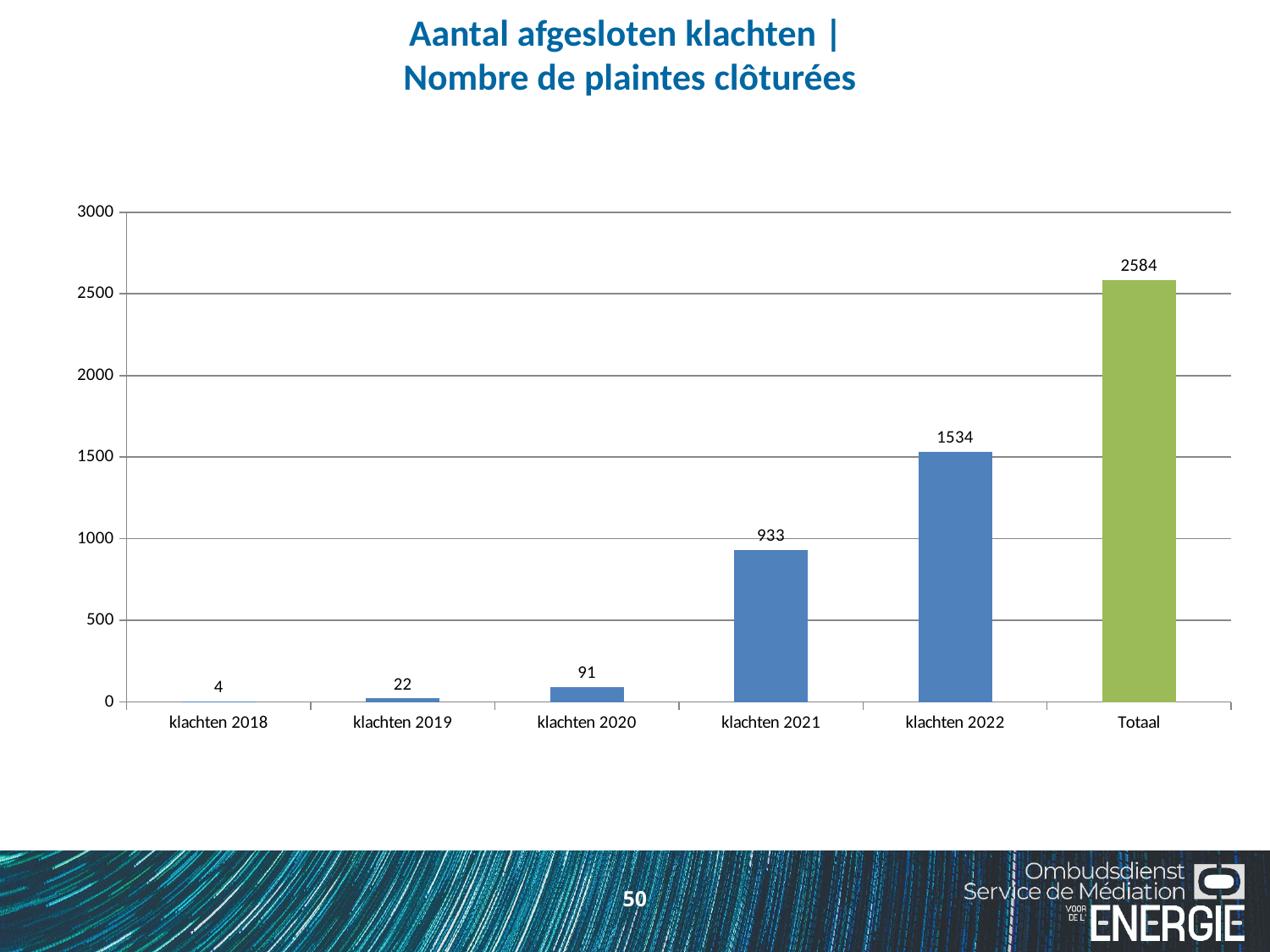
What is the value for Totaal? 2584 What kind of chart is shown on the slide? bar chart What is the difference between the values for klachten 2022 and klachten 2021? 601 What is the value for klachten 2022? 1534 How many categories are shown on the x axis? 6 Which is larger, the value for klachten 2020 or klachten 2019? klachten 2020 Is the value for klachten 2022 greater or less than 1000? greater Do the values rise or fall from klachten 2018 to klachten 2022? rise What is the value for klachten 2021? 933 What is the value for klachten 2018? 4 Which category has the highest value? Totaal Which category has the lowest value? klachten 2018